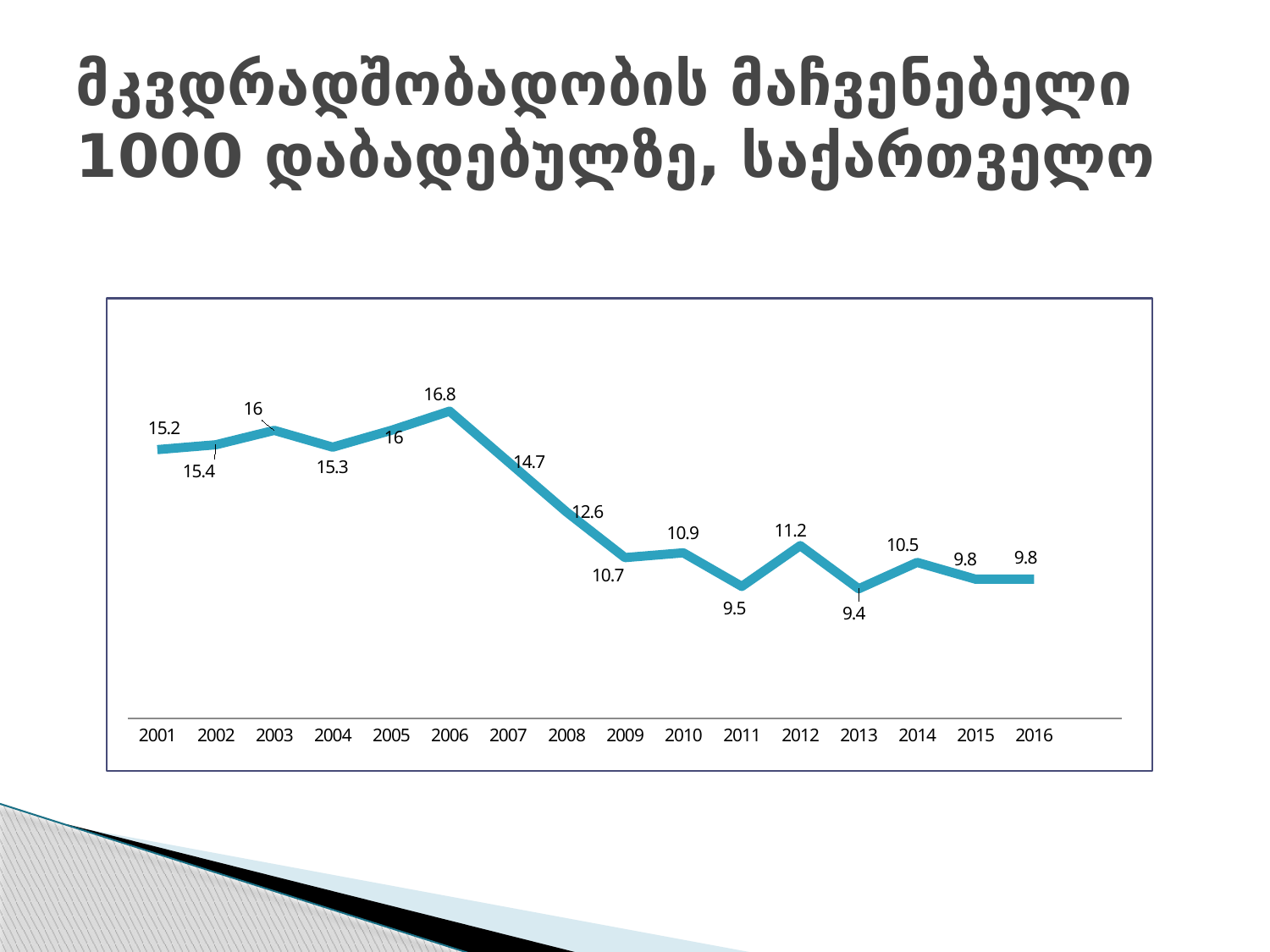
What is the value for 2012? 11.2 Do the values generally rise or fall from 2006 to 2016? Fall What is the difference between the values for 2006 and 2016? 7 What kind of chart is shown on the slide? Line chart Which year has the lowest value? 2013 Which is larger, the value for 2010 or the value for 2011? 2010 Which year has the highest value? 2006 What is the value for 2006? 16.8 What is the difference between the values for 2008 and 2009? 1.9 How many years are plotted on the x axis? 16 What is the value for 2001? 15.2 What is the value for 2013? 9.4